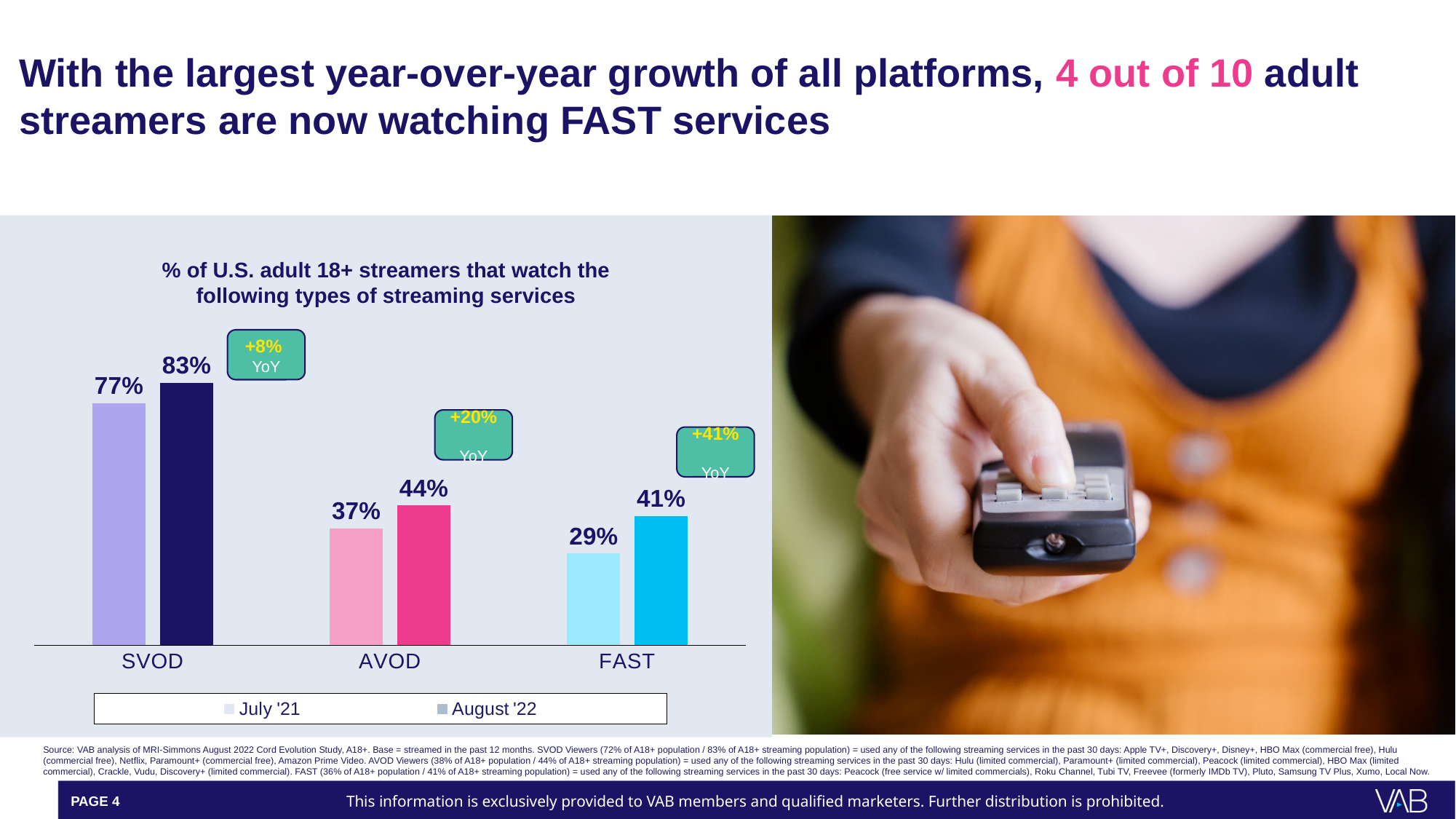
How many series does the legend list? 2 Which is larger, the August '22 value for AVOD or the August '22 value for FAST? AVOD What kind of chart is shown on the slide? Bar chart What is the title of the chart? % of U.S. adult 18+ streamers that watch the following types of streaming services What percentage of U.S. adult 18+ streamers watched SVOD services in August '22? 83% What is the difference between the August '22 and July '21 values for FAST? 12 percentage points Which type of streaming service has the lowest July '21 value? FAST Which type of streaming service has the highest August '22 value? SVOD What percentage of U.S. adult 18+ streamers watched FAST services in July '21? 29% What year-over-year growth is shown in the callout for FAST? +41% How many types of streaming services are shown on the x axis? 3 What is the August '22 value for AVOD? 44%